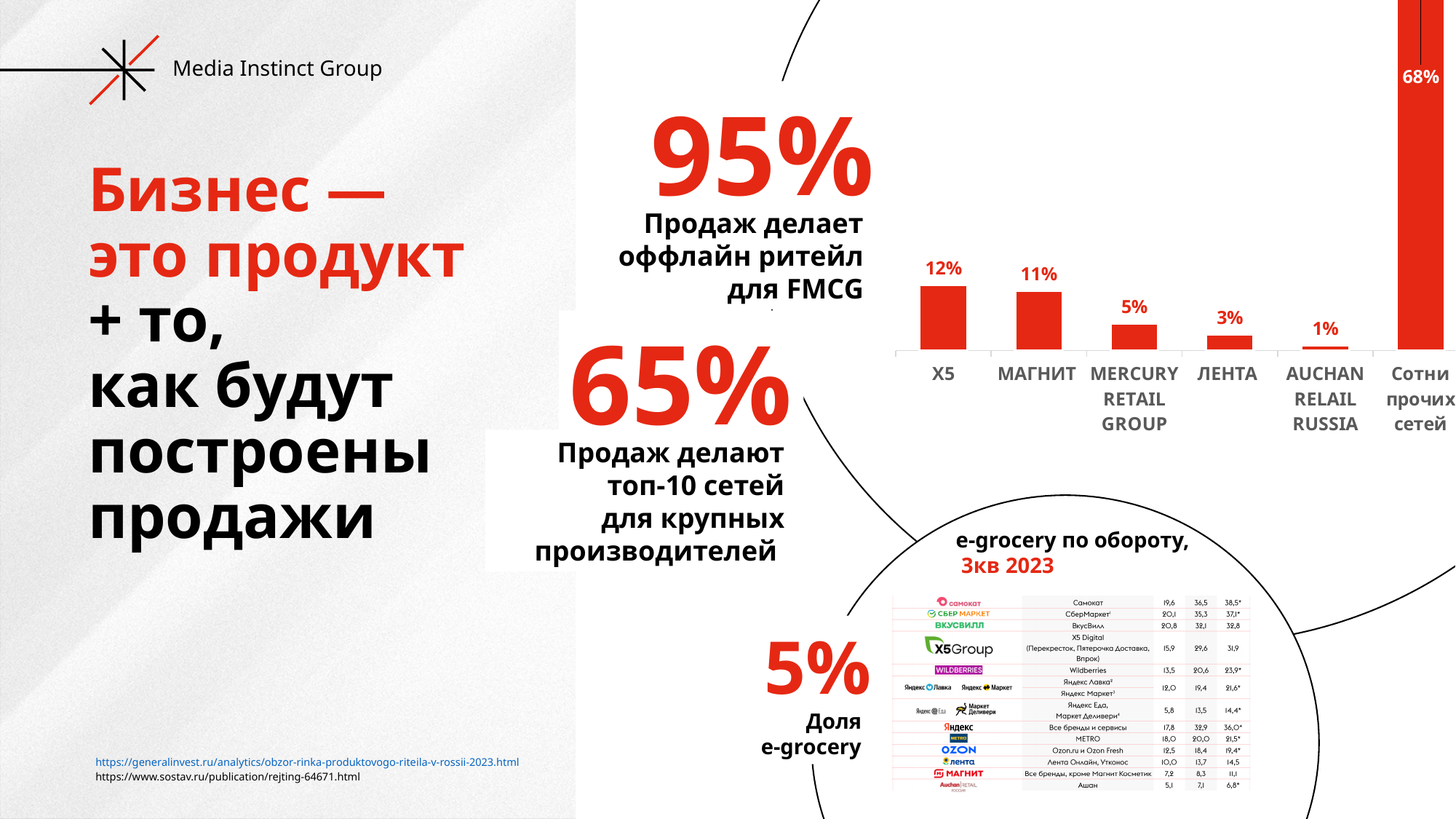
What is the value shown for МАГНИТ in the bar chart? 11% What is the value shown for AUCHAN RELAIL RUSSIA in the bar chart? 1% What type of chart is used to show the retail chain shares? Bar chart What is the value shown for X5 in the bar chart? 12% What is the difference between the values for X5 and ЛЕНТА in the bar chart? 9% What colour are the bars in the bar chart? Red How many categories are shown in the bar chart? 6 Which category has the highest value in the bar chart? Сотни прочих сетей What is the value shown for ЛЕНТА in the bar chart? 3% What is the value shown for MERCURY RETAIL GROUP in the bar chart? 5% Which category has the lowest value in the bar chart? AUCHAN RELAIL RUSSIA Which has a larger value in the bar chart, МАГНИТ or MERCURY RETAIL GROUP? МАГНИТ